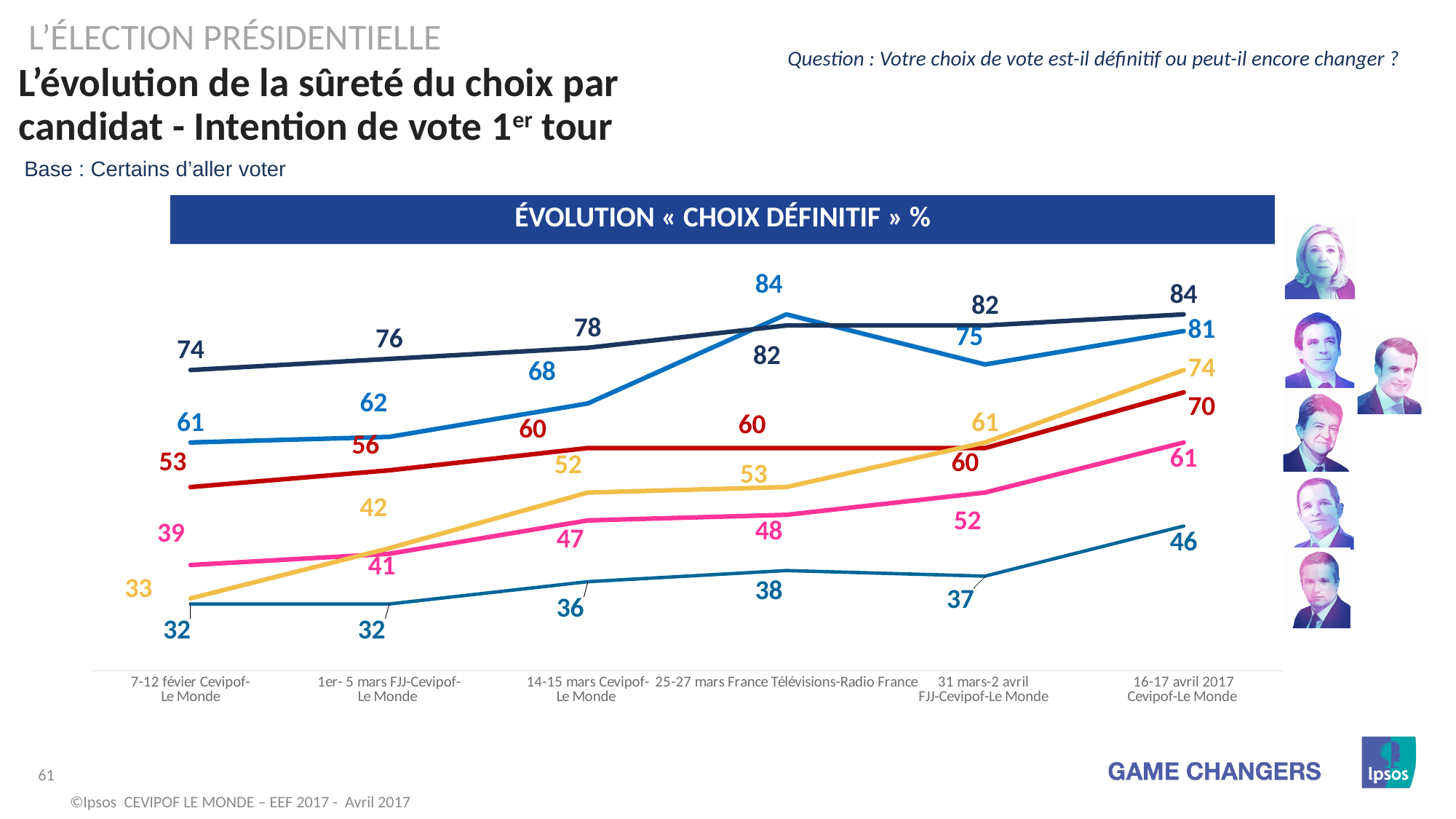
Which line has the highest value at 25-27 mars France Télévisions-Radio France? the bright blue line, 84 Which line has the lowest value at 16-17 avril 2017 Cevipof-Le Monde? the teal (bottom) line, 46 What is the title shown in the blue banner above the chart? ÉVOLUTION « CHOIX DÉFINITIF » % What is the value of the dark navy line at 16-17 avril 2017 Cevipof-Le Monde? 84 What is the value of the red line at 31 mars-2 avril FJJ-Cevipof-Le Monde? 60 How many lines (series) are plotted on the chart? 6 What is the difference between the yellow line's value at 16-17 avril 2017 (74) and at 7-12 février (33)? 41 What kind of chart is shown on the slide? line chart Does the pink line rise or fall from 7-12 février to 16-17 avril 2017? rises What is the value of the yellow line at 7-12 février Cevipof-Le Monde? 33 How many survey dates (points along the x axis) does the chart show? 6 At 14-15 mars Cevipof-Le Monde, which is larger: the red line or the yellow line? the red line (60)